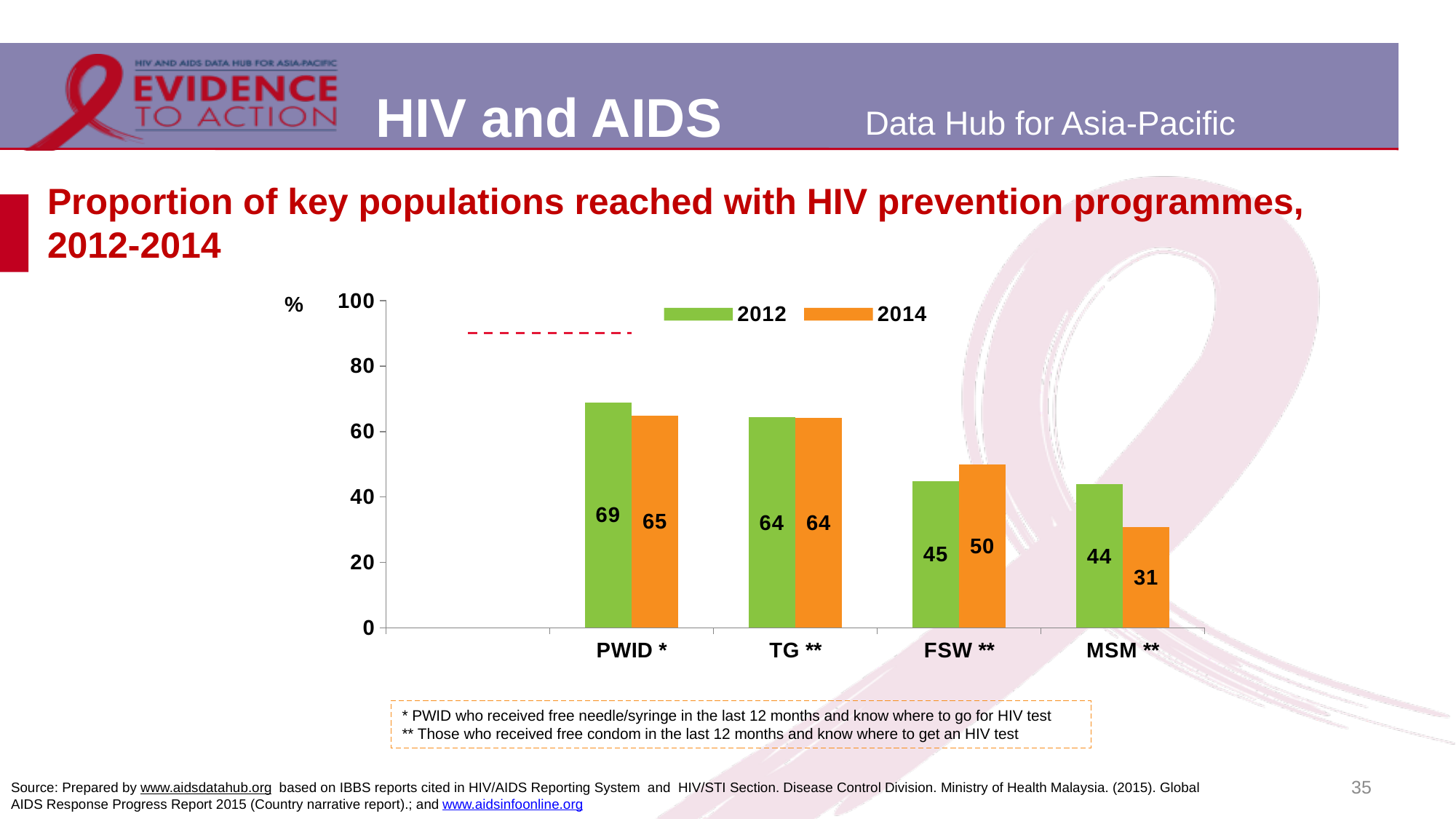
What is the 2012 value for PWID *? 69 How many series does the legend list? 2 Is the 2014 value for PWID * greater or less than 60? greater What is the 2014 value for FSW **? 50 Which category has the lowest 2014 value? MSM ** How many categories are shown on the x axis? 4 What kind of chart is shown on the slide? bar chart What is the 2014 value for MSM **? 31 Which is larger for FSW **, the 2012 value or the 2014 value? 2014 Which colour represents the 2014 series? orange Which category has the highest 2012 value? PWID * What is the difference between the 2012 and 2014 values for MSM **? 13